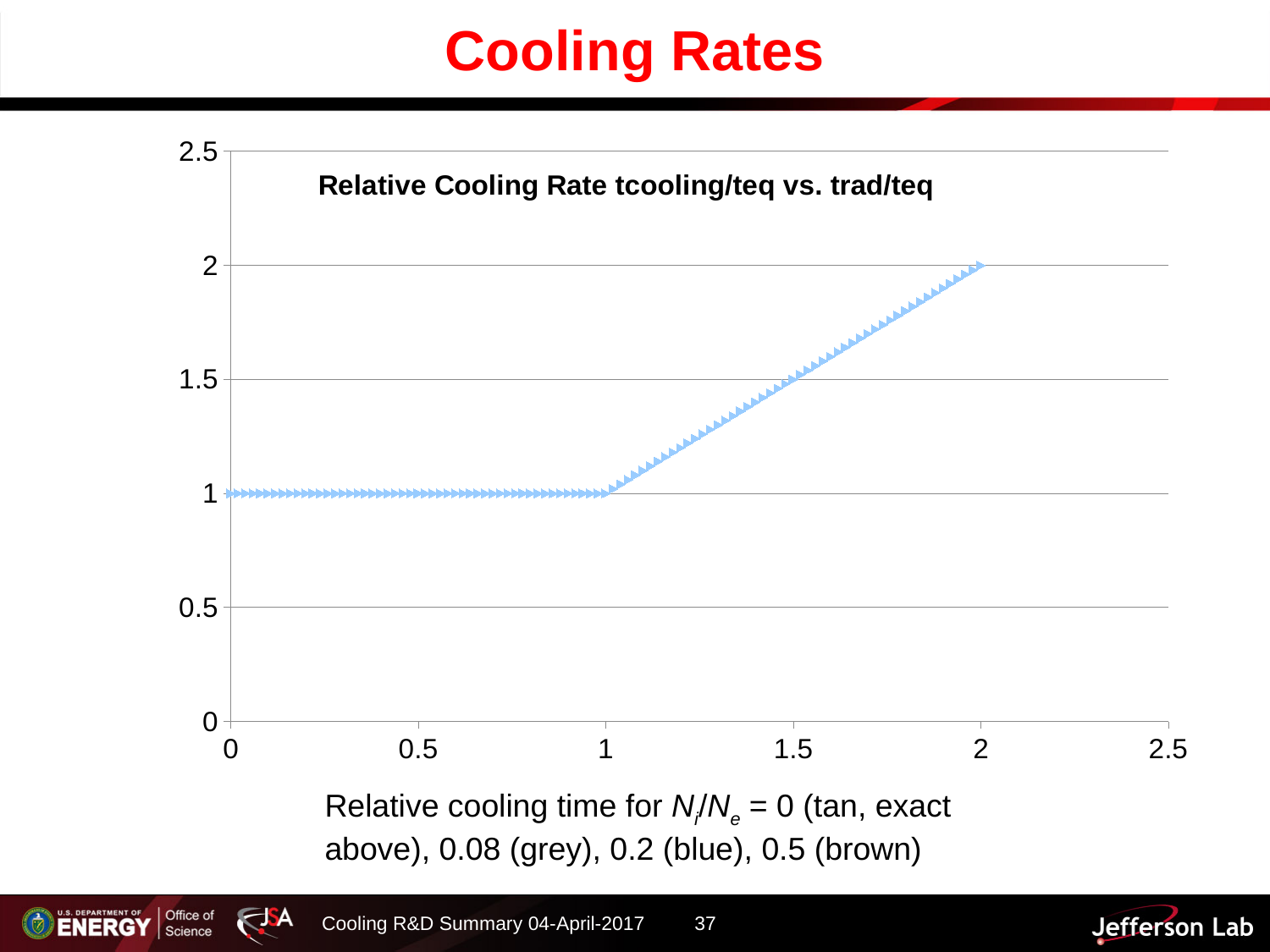
What is the plotted value at x = 1? 1 What is the difference between the plotted value at x = 2 and the plotted value at x = 1? 1 What is the plotted value at x = 2? 2 Do the plotted values rise, fall, or stay constant between x = 0 and x = 1? stay constant Is the plotted value at x = 0.75 greater or less than 1.5? less At which x value does the plotted series reach its highest value? 2 Do the plotted values rise or fall between x = 1 and x = 2? rise What is the title of the chart? Relative Cooling Rate tcooling/teq vs. trad/teq What is the plotted value at x = 0.5? 1 What kind of chart is shown on the slide? scatter chart What is the plotted value at x = 1.5? 1.5 Is the plotted value at x = 1.75 greater or less than 1.5? greater